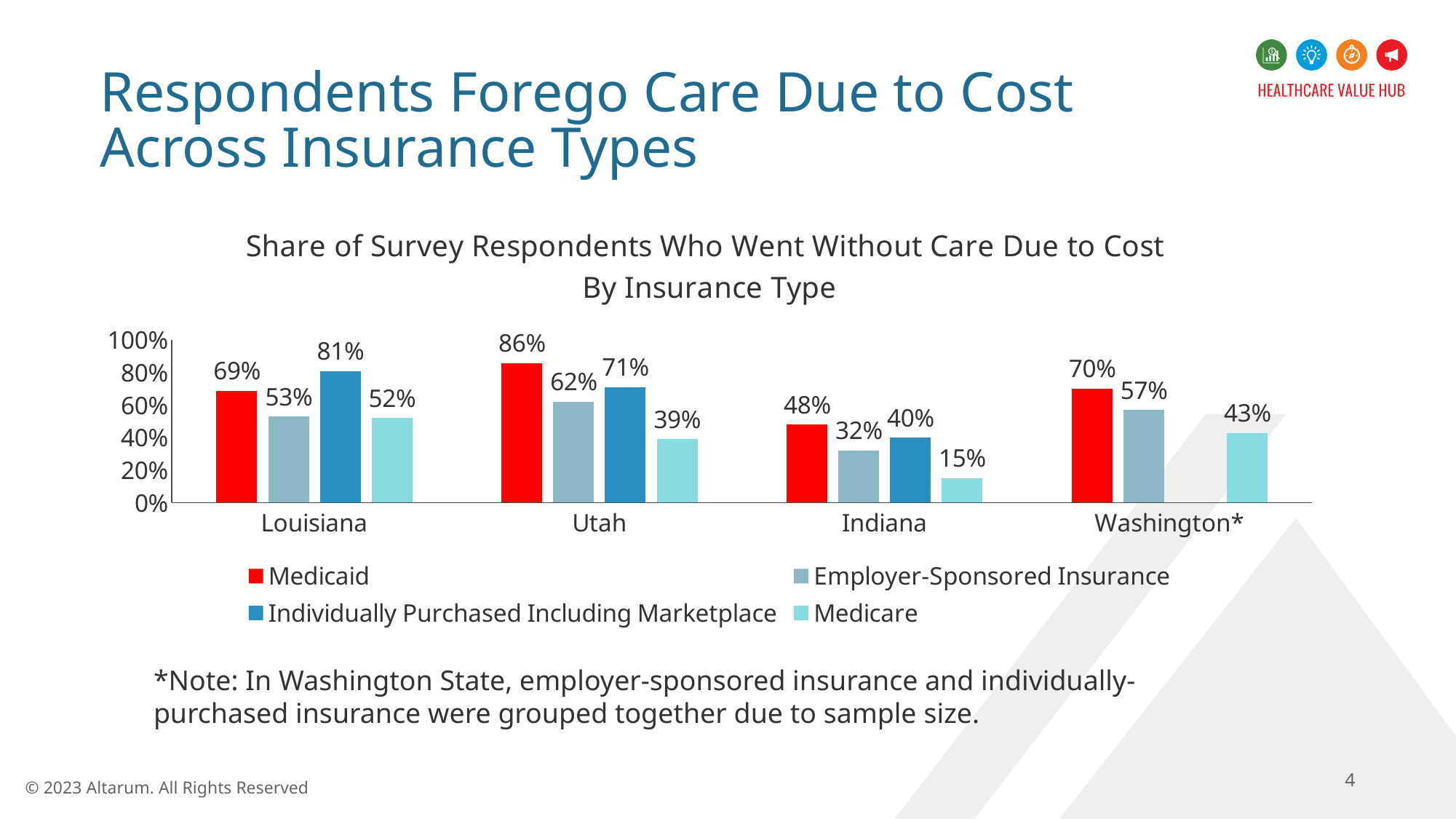
What is the value for Medicare in Indiana? 15% Which state has the highest Medicaid value? Utah How many states are shown on the x axis? 4 What colour represents Medicaid in the chart? Red What is the difference between the Medicaid and Medicare values in Louisiana? 17% How many series does the legend list? 4 What is the value for Employer-Sponsored Insurance in Washington*? 57% Which state has the lowest Medicare value? Indiana What is the value for Medicaid in Utah? 86% What kind of chart is shown on the slide? Bar chart Which is larger in Utah: Employer-Sponsored Insurance or Individually Purchased Including Marketplace? Individually Purchased Including Marketplace What is the value for Individually Purchased Including Marketplace in Louisiana? 81%